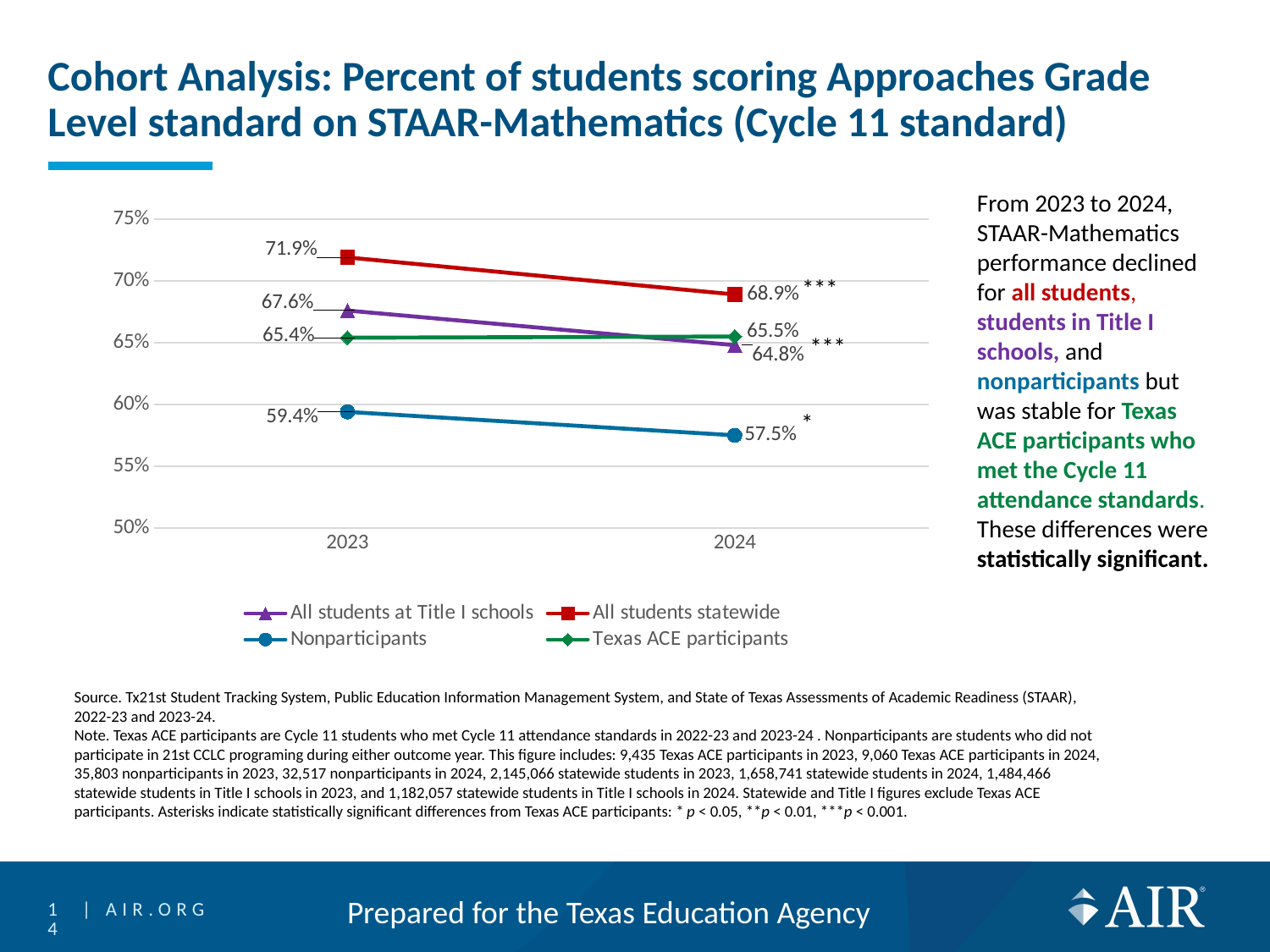
What was the value for All students statewide in 2023? 71.9% What was the value for Texas ACE participants in 2024? 65.5% What was the value for All students at Title I schools in 2023? 67.6% How many series does the legend list? 4 Which series had the lowest value in 2024? Nonparticipants Did the value for Nonparticipants rise or fall from 2023 to 2024? fall What type of chart is shown on the slide? line chart How many years are shown on the x axis? 2 By how many percentage points did the value for All students at Title I schools change from 2023 to 2024? 2.8 percentage points Which series had the highest value in 2023? All students statewide In 2024, which was larger: the value for All students statewide or the value for Texas ACE participants? All students statewide What was the value for Nonparticipants in 2024? 57.5%